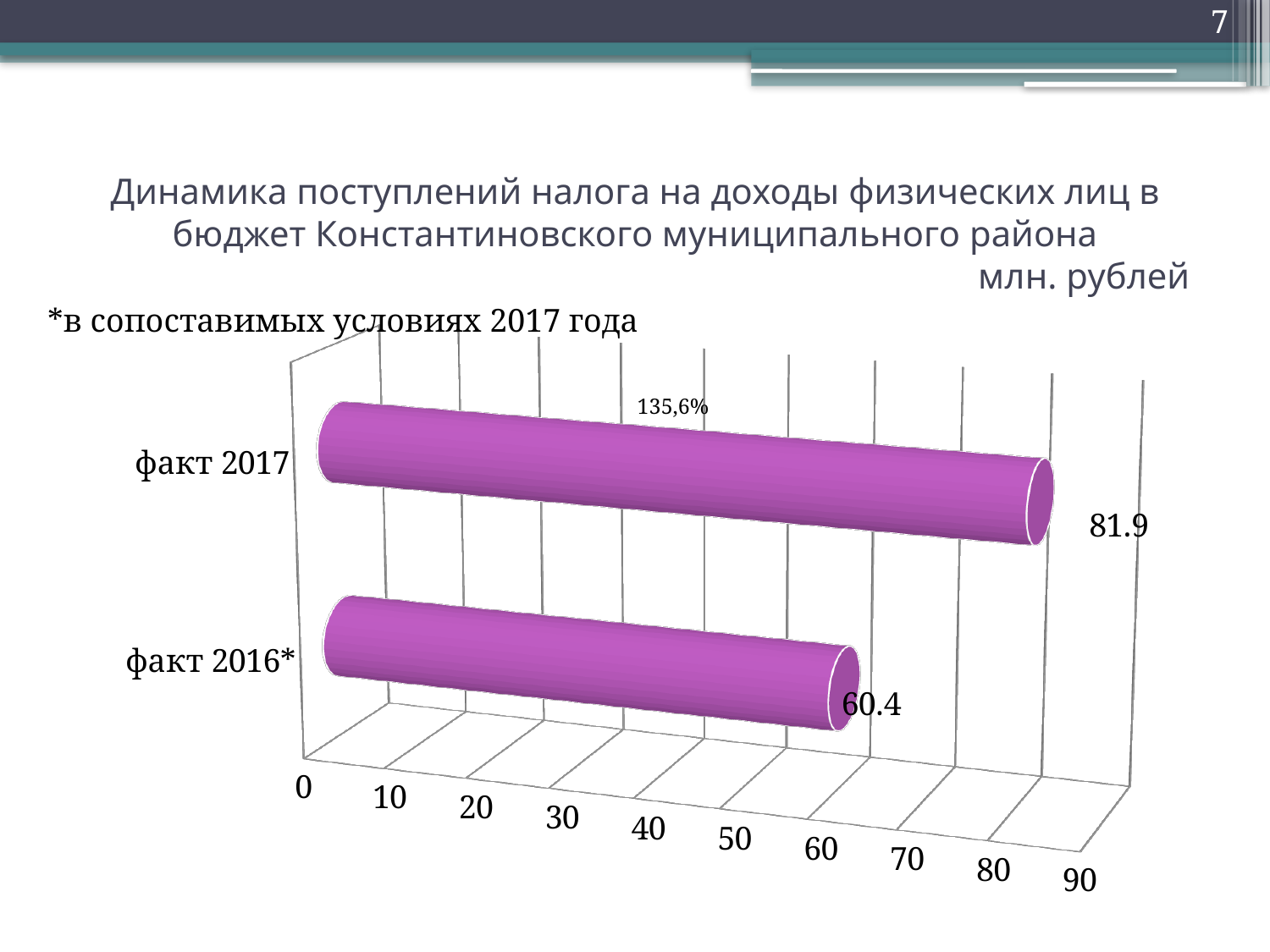
How many categories are shown in the chart? 2 Is the value for факт 2017 greater or less than 80? greater Which is larger, the value for факт 2017 or the value for факт 2016*? факт 2017 What unit of measurement is stated for the chart? млн. рублей Is the value for факт 2016* greater or less than 70? less Which category has the lowest value? факт 2016* What kind of chart is shown on the slide? bar chart What is the value for факт 2017? 81.9 What is the value for факт 2016*? 60.4 What is the difference between the values for факт 2017 and факт 2016*? 21.5 What percentage is printed above the факт 2017 bar? 135,6% Which category has the highest value? факт 2017